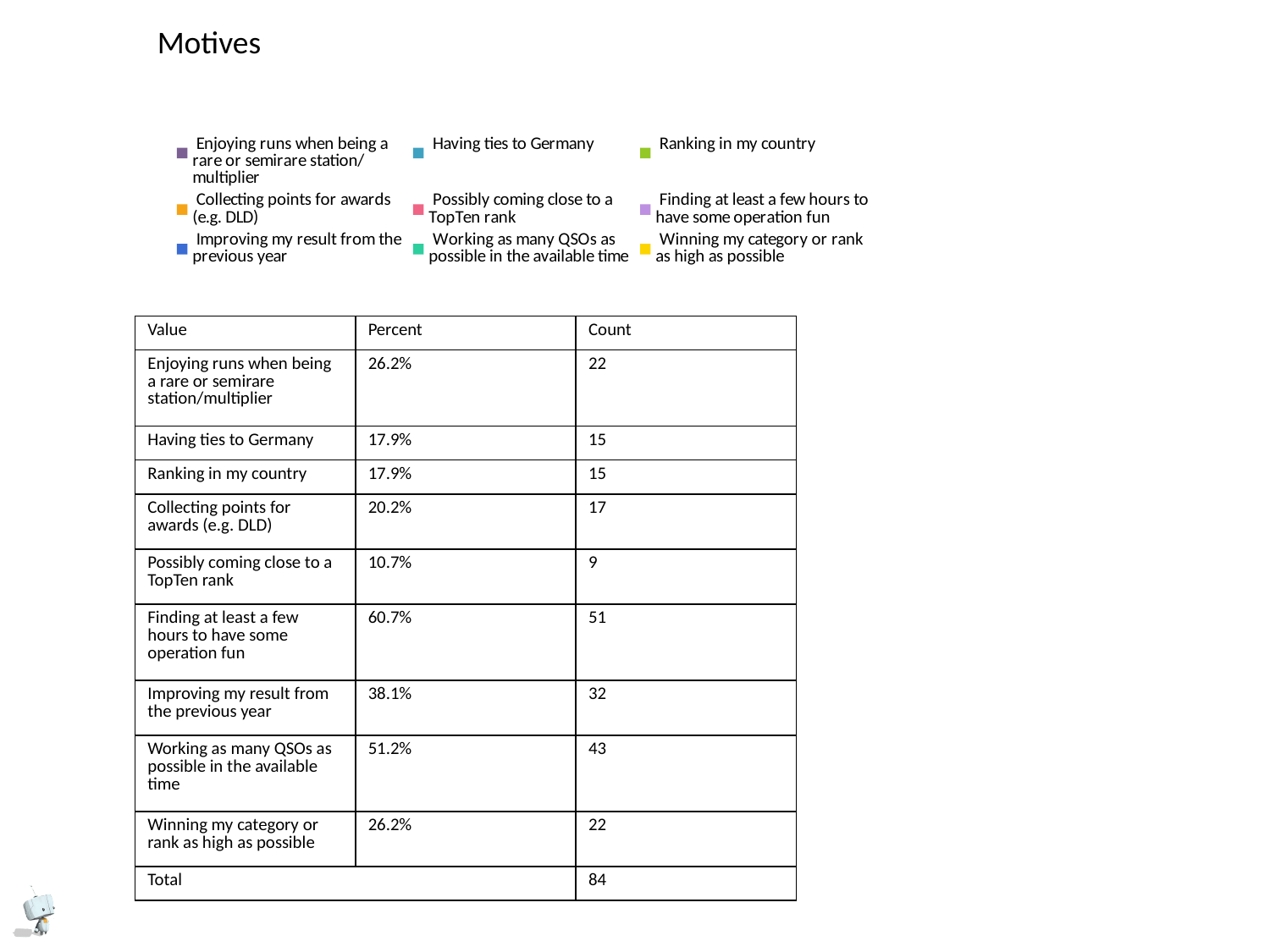
In the table below the legend, what is the percent for "Finding at least a few hours to have some operation fun"? 60.7% In the table below the legend, what is the total count? 84 In the table below the legend, what is the count for "Working as many QSOs as possible in the available time"? 43 In the table below the legend, which motive has the lowest count? Possibly coming close to a TopTen rank What colour is the legend marker for "Having ties to Germany"? Blue In the table below the legend, which has the larger count: "Ranking in my country" or "Winning my category or rank as high as possible"? Winning my category or rank as high as possible In the table below the legend, what is the difference in count between "Improving my result from the previous year" and "Collecting points for awards (e.g. DLD)"? 15 In the table below the legend, which motive has the highest count? Finding at least a few hours to have some operation fun How many motives are listed in the table below the legend (excluding the Total row)? 9 How many entries does the chart legend on the slide list? 9 What is the title of the slide containing the chart legend? Motives